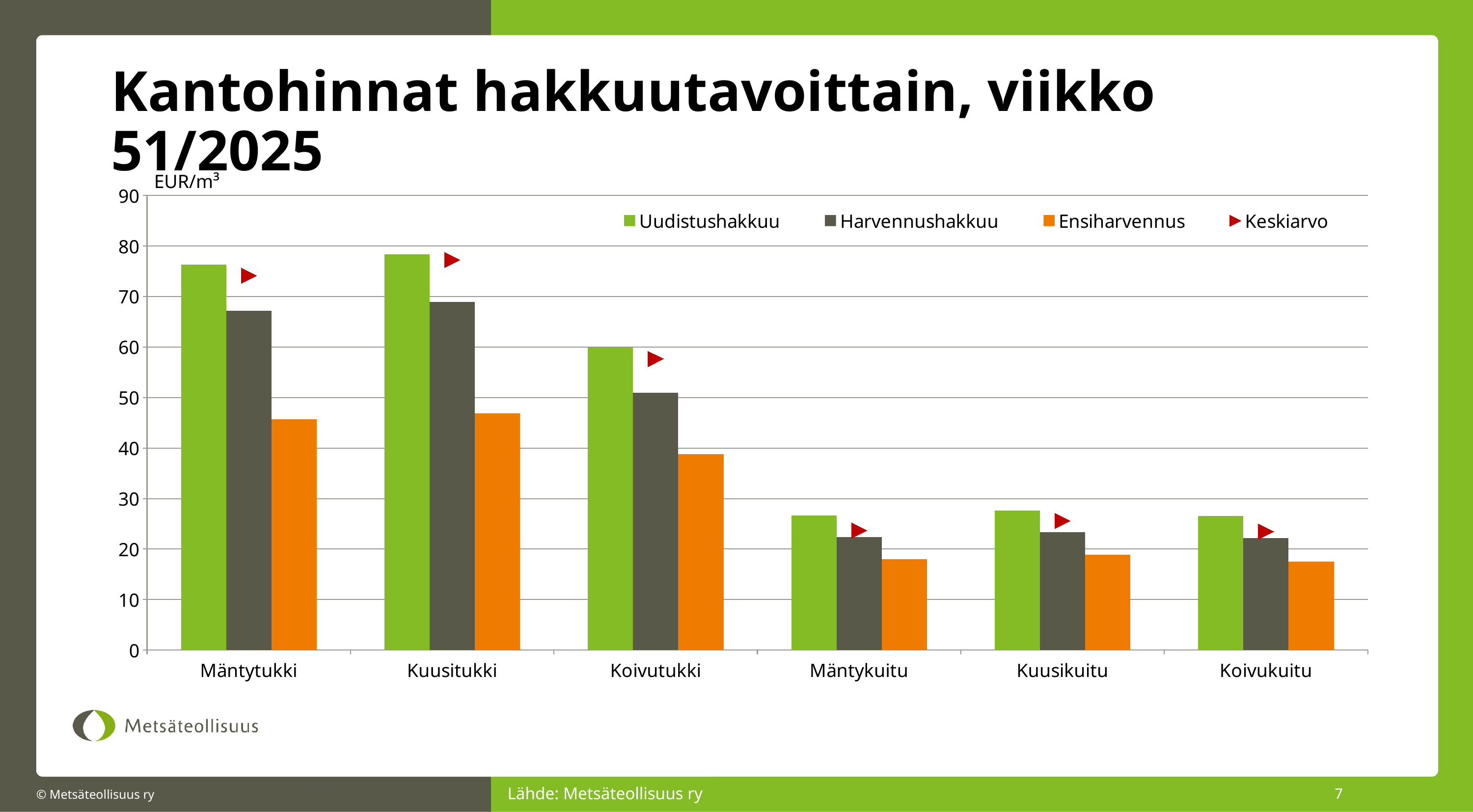
Which is larger: the Ensiharvennus value for Koivutukki or for Mäntykuitu? Koivutukki How many series does the legend list? 4 Which is larger: the Uudistushakkuu value for Mäntytukki or for Koivutukki? Mäntytukki Is the Ensiharvennus value for Koivutukki greater or less than 40? less Is the Harvennushakkuu value for Kuusikuitu greater or less than 30? less How many categories are shown on the x axis? 6 Is the Uudistushakkuu value for Mäntytukki greater or less than 70? greater Which category has the highest Uudistushakkuu value? Kuusitukki What kind of chart is shown on the slide? bar chart What unit is shown above the y axis of the chart? EUR/m³ Which category has the lowest Harvennushakkuu value among the three tukki categories (Mäntytukki, Kuusitukki, Koivutukki)? Koivutukki